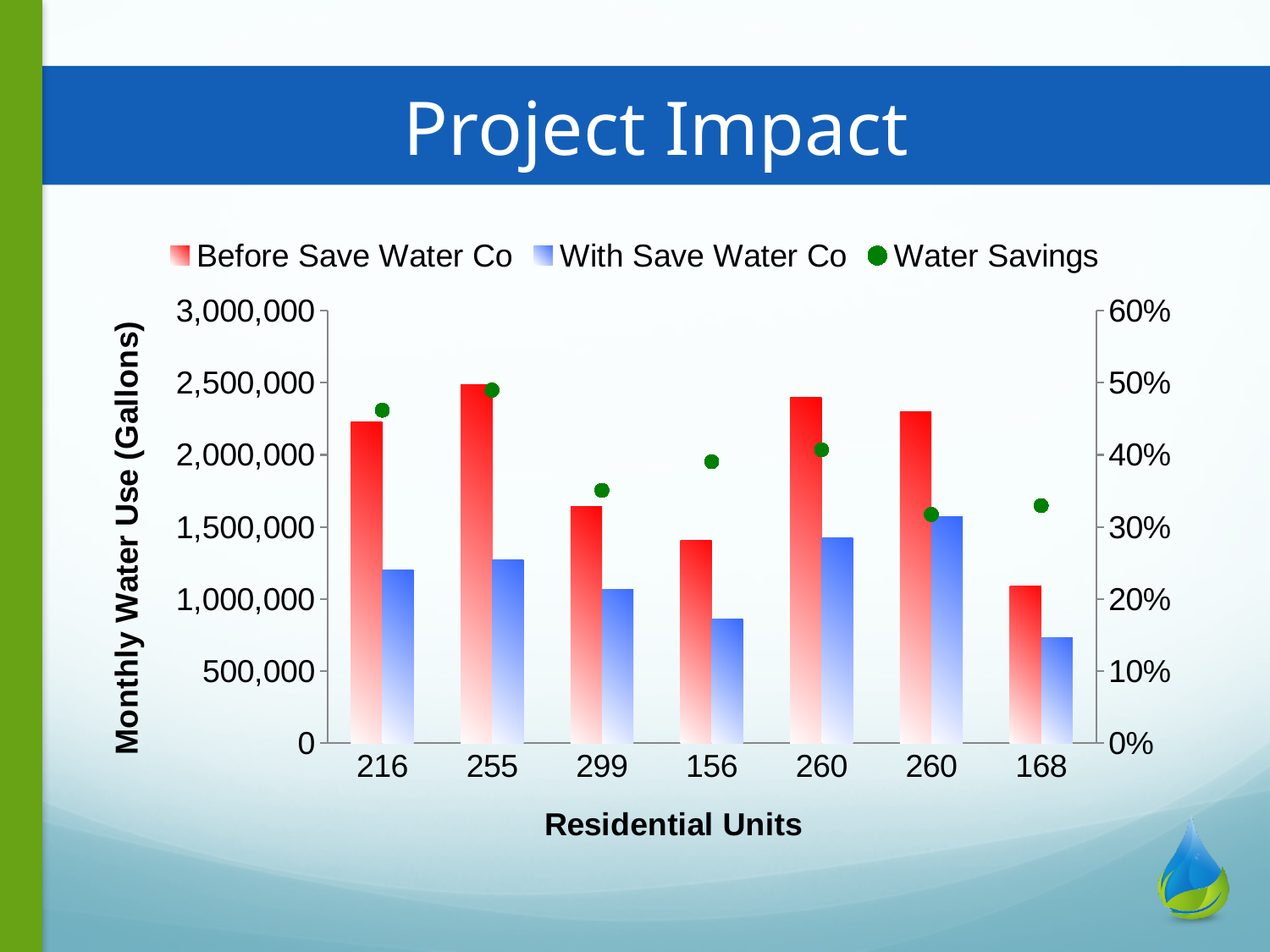
What is the label of the left vertical axis? Monthly Water Use (Gallons) Which residential unit category has the highest Before Save Water Co value? 255 Is the Before Save Water Co value for 216 residential units greater or less than 2,000,000? greater Which residential unit category has the lowest Before Save Water Co value? 168 How many series does the legend list? 3 Which is larger, the Before Save Water Co value for 216 residential units or for 299 residential units? 216 Is the With Save Water Co value for 156 residential units greater or less than 1,000,000? less Which residential unit category has the lowest With Save Water Co value? 168 How many residential unit categories are shown on the x axis? 7 Which residential unit category has the highest Water Savings percentage? 255 What is the title of the chart on the slide? Project Impact Is the Water Savings value for 299 residential units greater or less than 40%? less